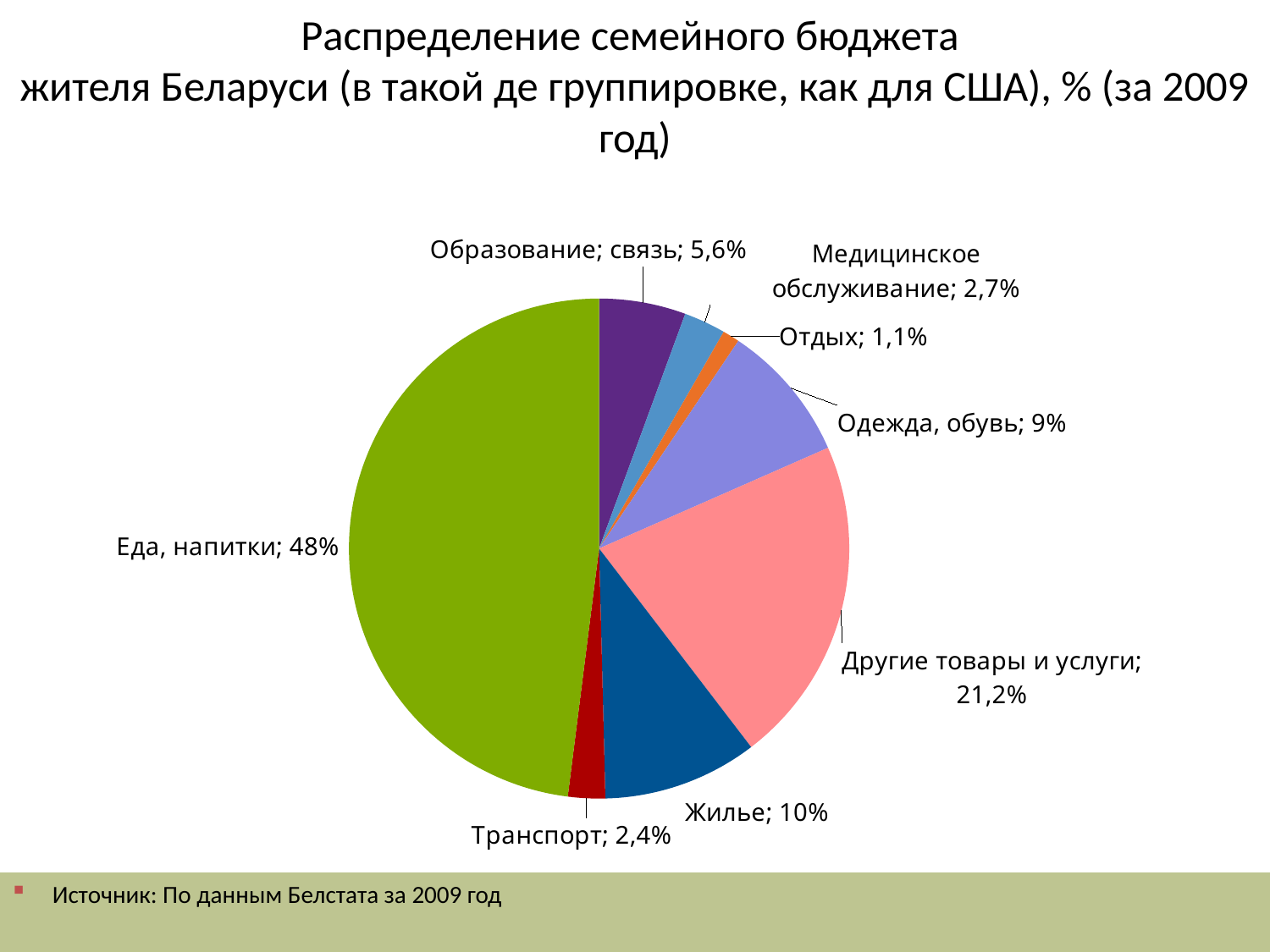
What kind of chart is shown on the slide? pie chart What is the value for Другие товары и услуги? 21,2% What share of the family budget goes to Еда, напитки? 48% What is the value for Жилье? 10% What is the value for Транспорт? 2,4% Which is larger, the share for Одежда, обувь or the share for Образование; связь? Одежда, обувь How many categories (slices) does the pie chart have? 8 What is the value for Медицинское обслуживание? 2,7% Which category has the smallest share of the budget? Отдых Which category has the largest share of the budget? Еда, напитки What is the difference between the shares for Еда, напитки and Другие товары и услуги? 26,8% According to the footer, what is the source of the data? По данным Белстата за 2009 год